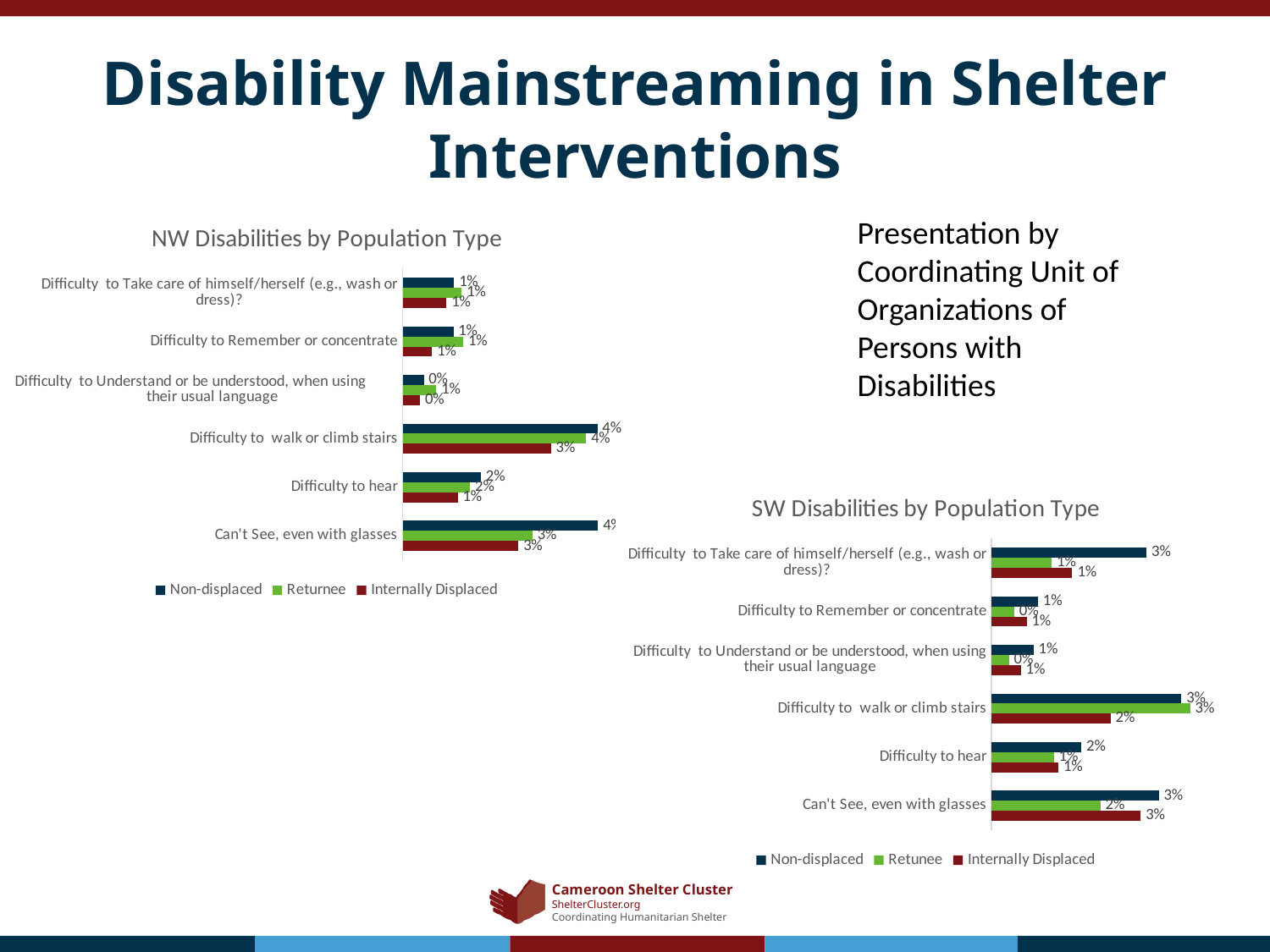
What type of chart is the SW Disabilities by Population Type chart? Bar chart In the NW Disabilities by Population Type chart, which category has the lowest Non-displaced value? Difficulty to Understand or be understood, when using their usual language In the NW Disabilities by Population Type chart, what is the Returnee value for Difficulty to walk or climb stairs? 4% In the SW Disabilities by Population Type chart, what is the difference between the Non-displaced and Returnee values for Difficulty to Take care of himself/herself (e.g., wash or dress)? 2 percentage points In the NW Disabilities by Population Type chart, which category has the highest Returnee value? Difficulty to walk or climb stairs In the NW Disabilities by Population Type chart, what is the Internally Displaced value for Difficulty to hear? 1% In the SW Disabilities by Population Type chart, which category has the highest Internally Displaced value? Can't See, even with glasses In the SW Disabilities by Population Type chart, what is the Internally Displaced value for Difficulty to walk or climb stairs? 2% How many categories are shown in the SW Disabilities by Population Type chart? 6 In the SW Disabilities by Population Type chart, what is the Non-displaced value for Difficulty to Take care of himself/herself (e.g., wash or dress)? 3% In the SW Disabilities by Population Type chart, which is larger for Difficulty to walk or climb stairs: the Non-displaced value or the Internally Displaced value? Non-displaced How many series does the legend of the NW Disabilities by Population Type chart list? 3